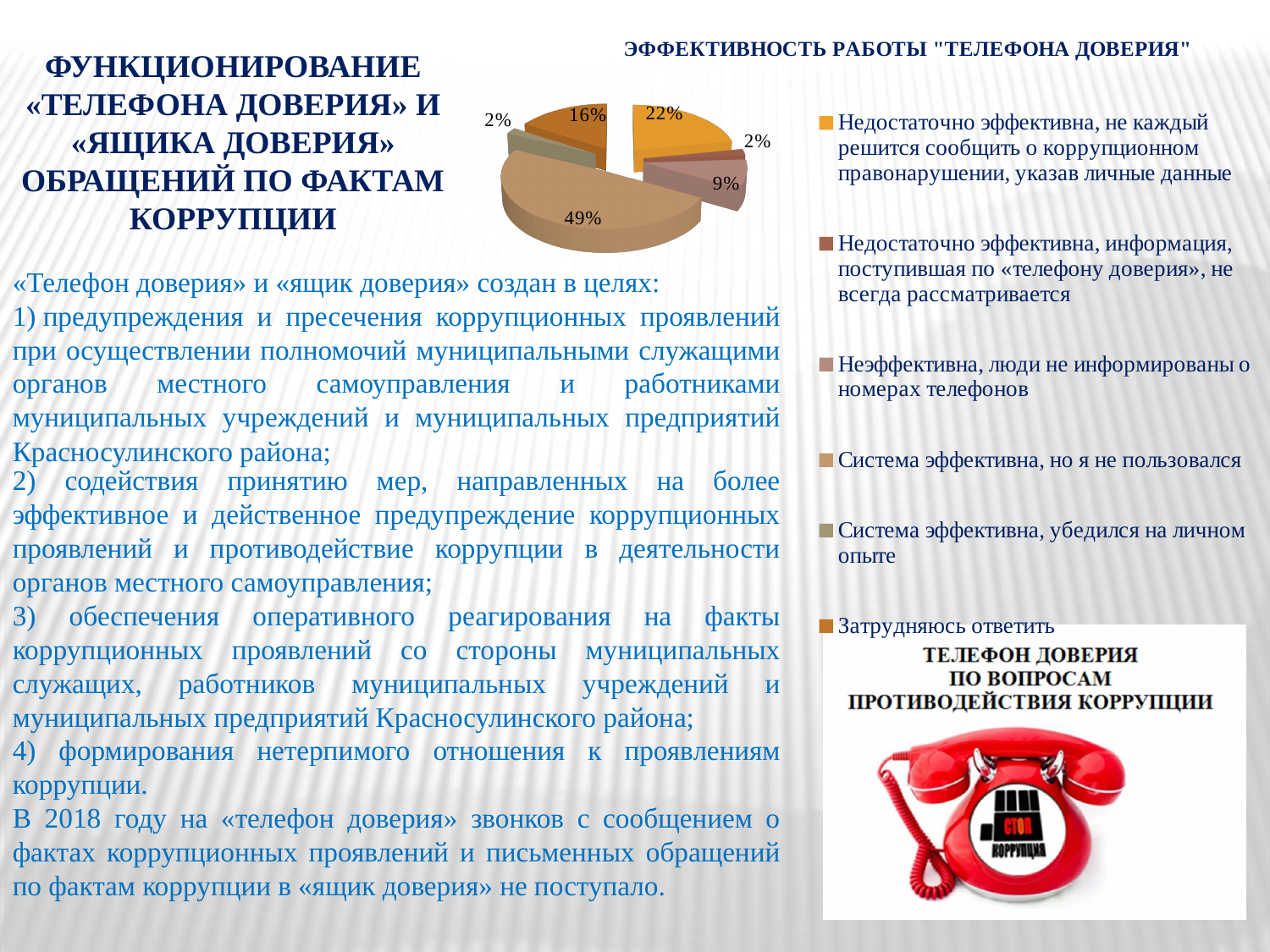
What is the title of the chart? ЭФФЕКТИВНОСТЬ РАБОТЫ "ТЕЛЕФОНА ДОВЕРИЯ" What kind of chart is shown on the slide? pie chart What share of the pie is labelled for "Неэффективна, люди не информированы о номерах телефонов"? 9% How many slices does the pie chart have? 6 How many entries does the chart legend list? 6 What is the smallest percentage shown on the pie chart? 2% What share of the pie is labelled for "Затрудняюсь ответить"? 16% What is the largest percentage shown on the pie chart? 49% Which category has the largest share of the pie? Система эффективна, но я не пользовался What is the difference between the 49% slice and the 22% slice? 27% What share of the pie is labelled for "Недостаточно эффективна, не каждый решится сообщить о коррупционном правонарушении, указав личные данные"? 22% Which is larger: the share for "Затрудняюсь ответить" or the share for "Неэффективна, люди не информированы о номерах телефонов"? Затрудняюсь ответить